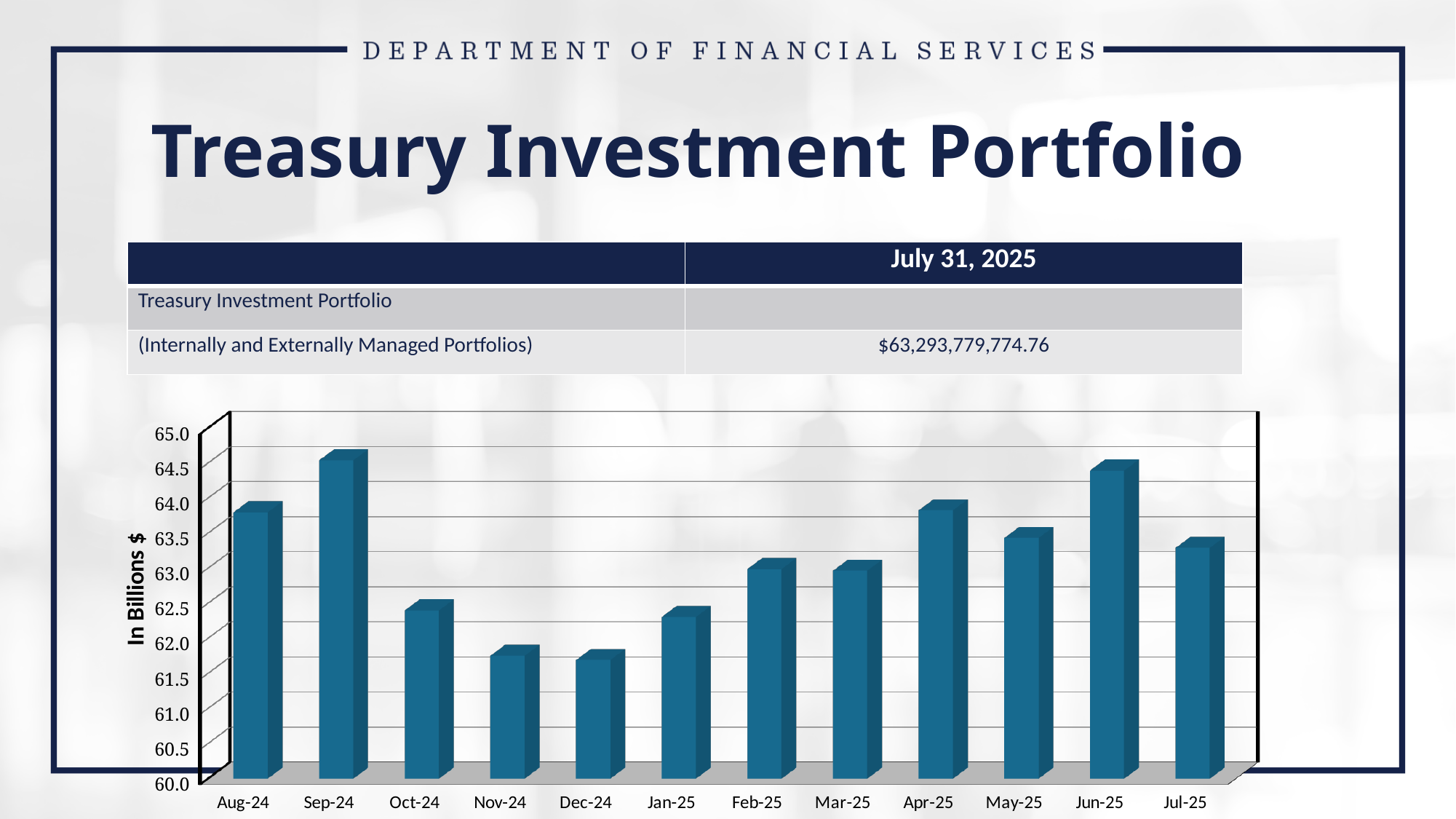
What kind of chart is shown on the slide? Bar chart Is the value for Sep-24 greater or less than 64.0? greater Which is larger, the value for Apr-25 or the value for Jan-25? Apr-25 Which is larger, the value for Sep-24 or the value for Oct-24? Sep-24 Is the value for Nov-24 greater or less than 62.0? less Is the value for Jul-25 greater or less than 64.0? less Do the values rise or fall from Dec-24 to Apr-25? rise How many months are plotted on the x axis of the chart? 12 What is the label on the vertical axis of the chart? In Billions $